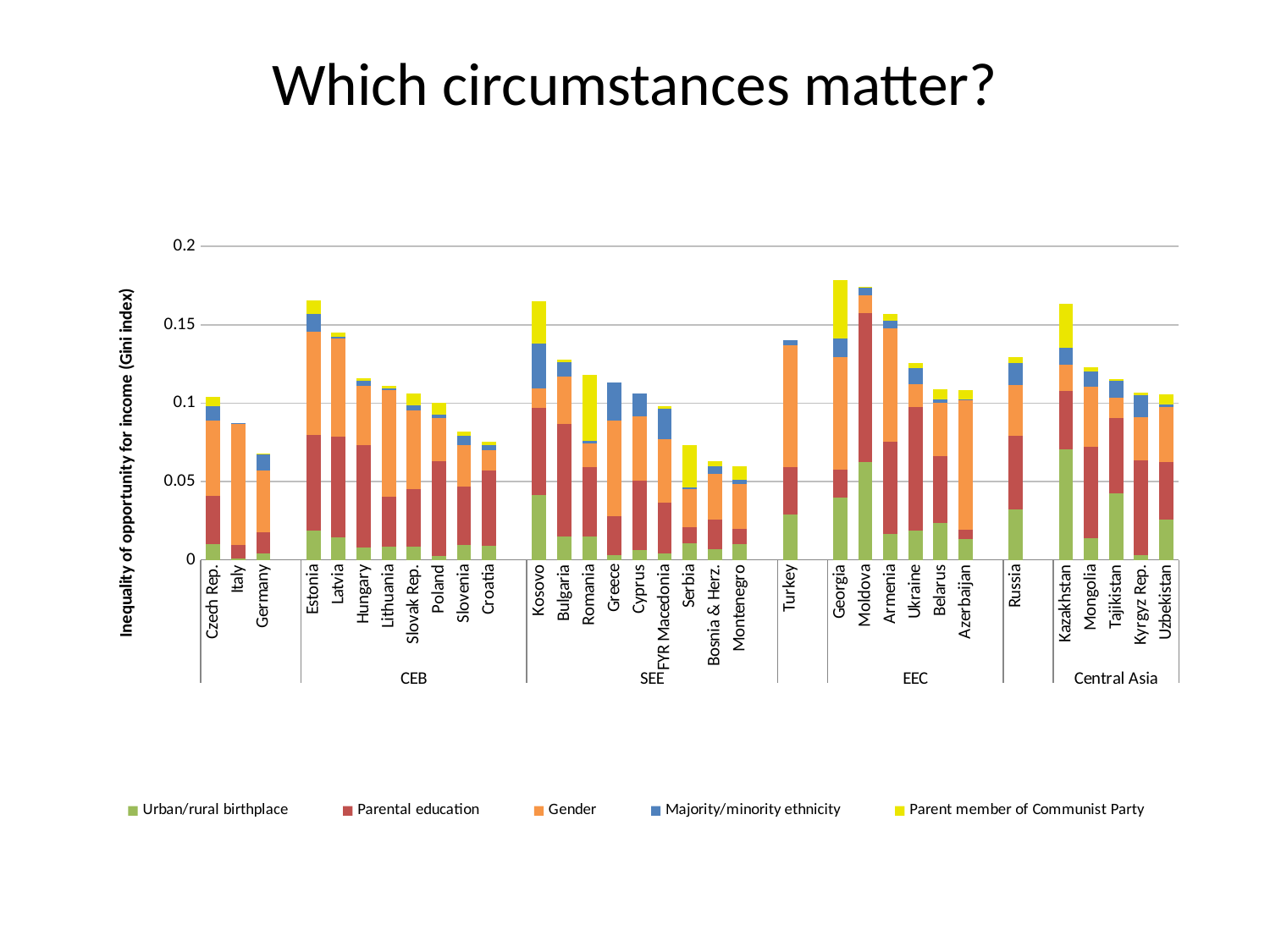
What is the label on the vertical axis of the chart? Inequality of opportunity for income (Gini index) How many series does the legend list? 5 What kind of chart is shown on the slide? Stacked bar chart Is the total value for Serbia greater or less than 0.1? less Is the total value for Estonia greater or less than 0.15? greater Is the total value for Germany greater or less than 0.1? less What is the title of the slide? Which circumstances matter? How many countries are plotted on the x axis? 33 Which has the larger total bar, Kosovo or Montenegro? Kosovo Which has the larger total bar, Estonia or Germany? Estonia